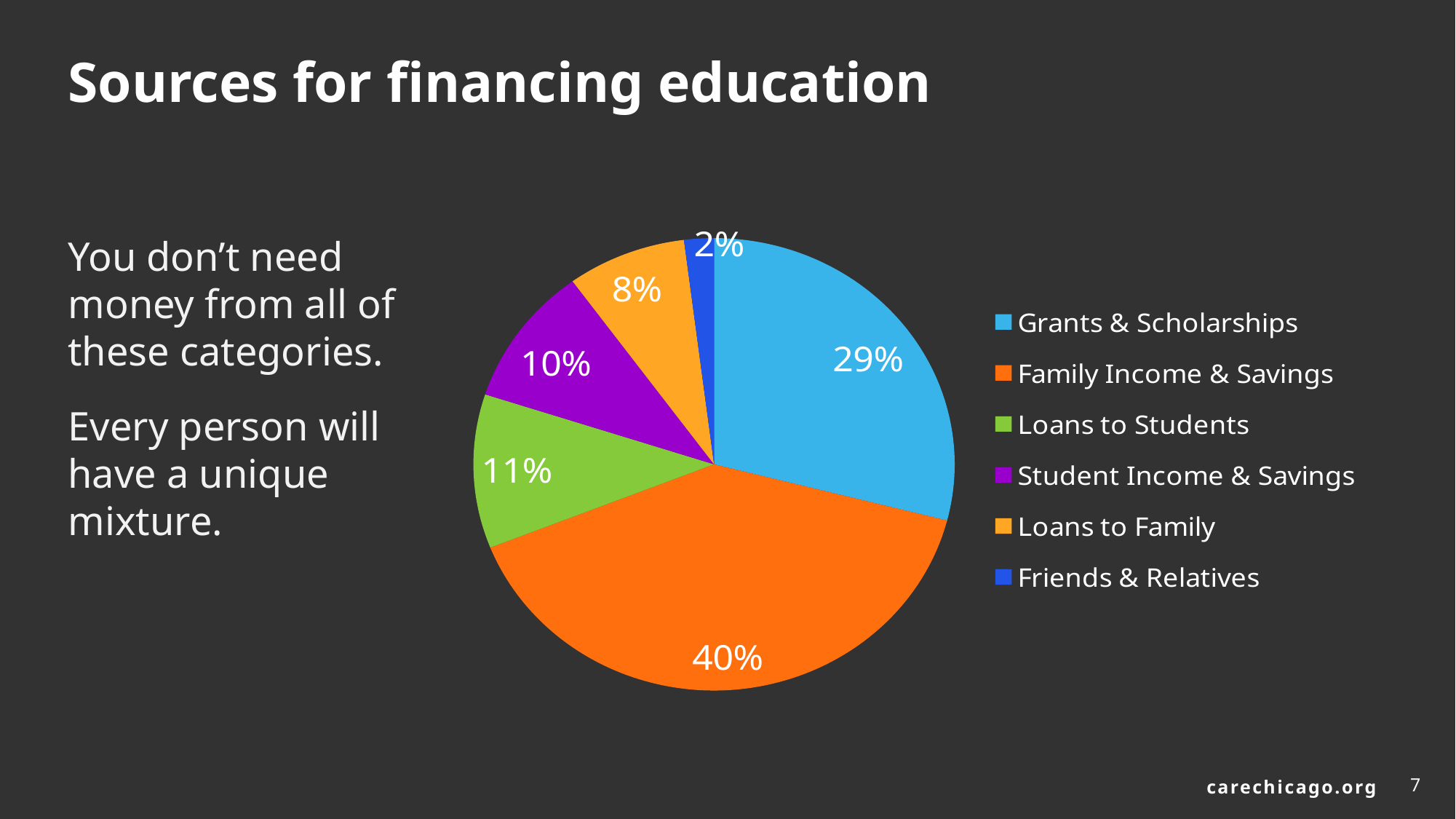
What share of the pie is Friends & Relatives? 2% Which is larger, the share for Loans to Students or the share for Loans to Family? Loans to Students What share of the pie is Grants & Scholarships? 29% Which category has the largest share of the pie? Family Income & Savings What share of the pie is Loans to Students? 11% Which category has the smallest share of the pie? Friends & Relatives What kind of chart is shown on the slide? Pie chart What is the difference between the shares for Family Income & Savings and Grants & Scholarships? 11% How many categories does the legend list? 6